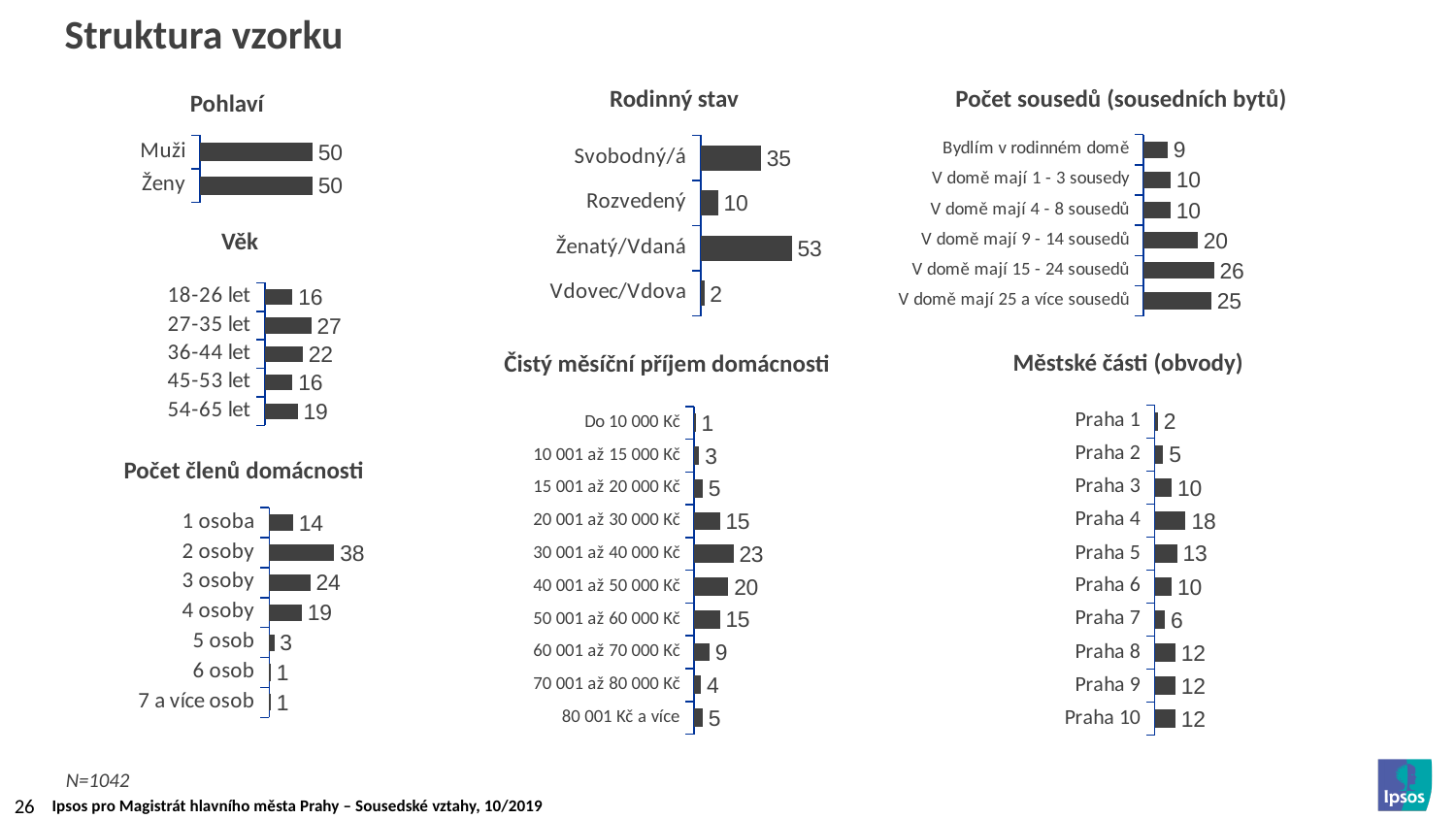
What type of chart is used for "Počet sousedů (sousedních bytů)"? Bar chart In the "Čistý měsíční příjem domácnosti" chart, how many income categories are shown? 10 In the "Počet členů domácnosti" chart, how many categories are shown? 7 In the "Počet sousedů (sousedních bytů)" chart, what is the difference between "V domě mají 15 - 24 sousedů" and "Bydlím v rodinném domě"? 17 In the "Pohlaví" chart, what is the value for Muži? 50 In the "Městské části (obvody)" chart, which district has the lowest value? Praha 1 In the "Věk" chart, which age group has the highest value? 27-35 let In the "Čistý měsíční příjem domácnosti" chart, which income category has the highest value? 30 001 až 40 000 Kč In the "Počet členů domácnosti" chart, what is the value for 2 osoby? 38 In the "Rodinný stav" chart, which is larger: Svobodný/á or Rozvedený? Svobodný/á In the "Městské části (obvody)" chart, what is the value for Praha 4? 18 In the "Rodinný stav" chart, what is the value for Ženatý/Vdaná? 53